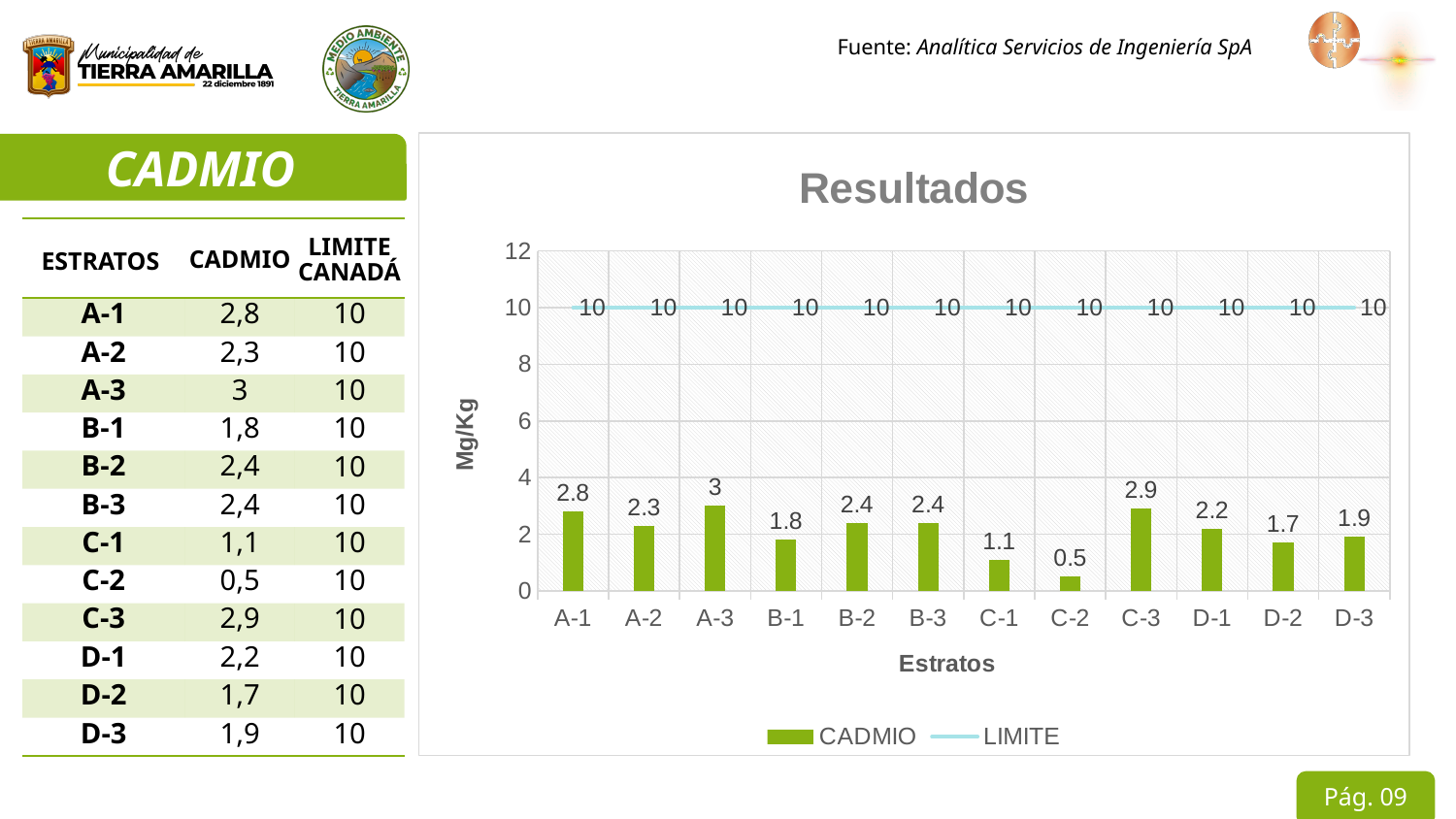
Which estrato has the highest CADMIO value in the Resultados chart? A-3 Which estrato has the lowest CADMIO value in the Resultados chart? C-2 What kind of chart is used to show the CADMIO values in the Resultados chart? bar chart Is the CADMIO value for B-2 greater or less than 4 in the Resultados chart? less How many series does the legend of the Resultados chart list? 2 What is the difference between the CADMIO values for C-3 and C-1 in the Resultados chart? 1.8 Which has a larger CADMIO value in the Resultados chart, A-1 or D-1? A-1 What is the CADMIO value for C-2 in the Resultados chart? 0.5 How many estratos are shown on the x axis of the Resultados chart? 12 What is the LIMITE value shown for B-1 in the Resultados chart? 10 What is the label of the y axis in the Resultados chart? Mg/Kg What is the CADMIO value for A-3 in the Resultados chart? 3